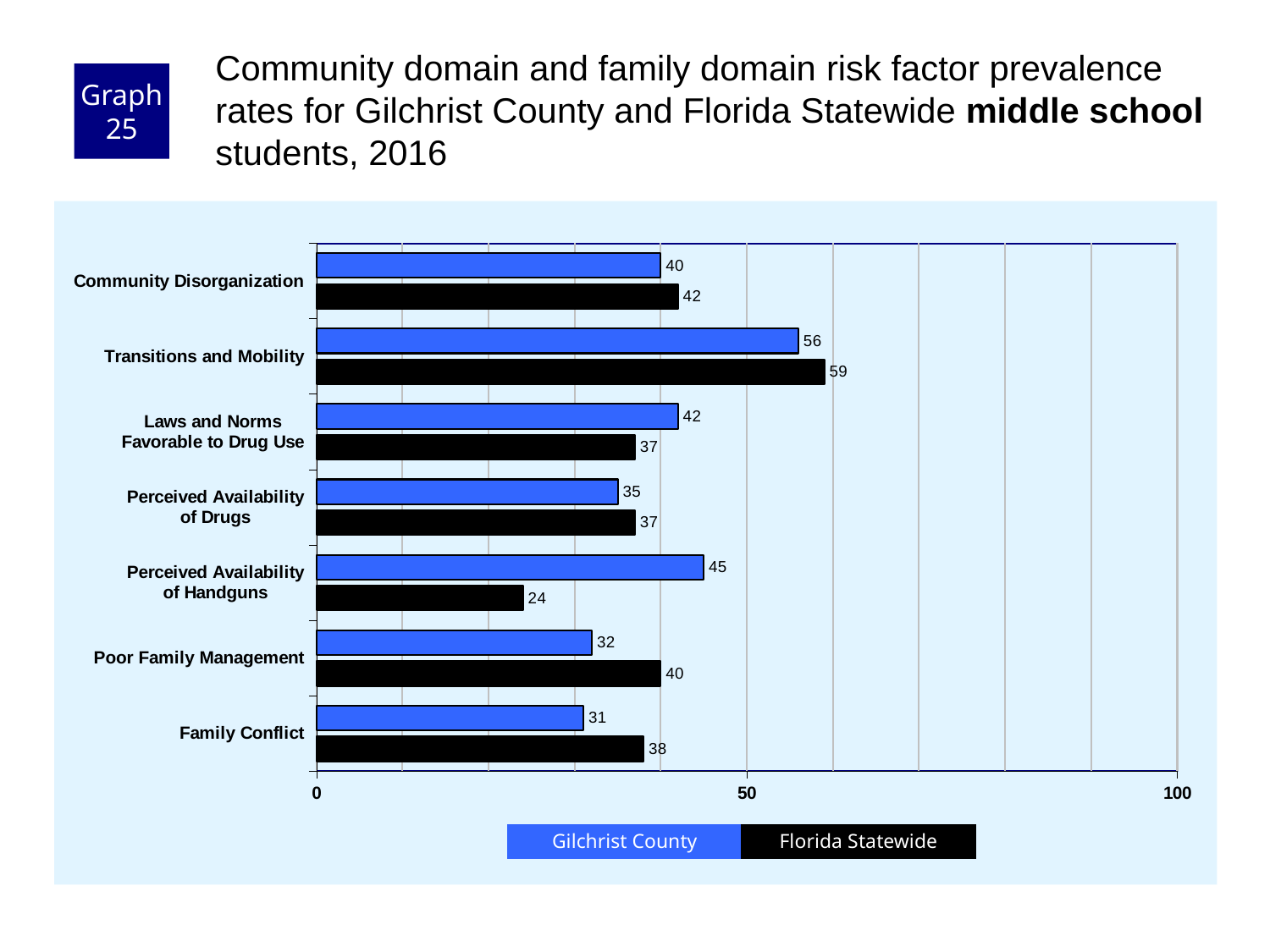
How many series does the legend list? 2 What is the Gilchrist County value for Transitions and Mobility? 56 What is the Gilchrist County value for Family Conflict? 31 Which risk factor has the lowest Gilchrist County value? Family Conflict Is the Florida Statewide value for Transitions and Mobility greater or less than 50? greater What kind of chart is shown on the slide? Bar chart Which risk factor has the highest Florida Statewide value? Transitions and Mobility What is the difference between the Gilchrist County and Florida Statewide values for Perceived Availability of Handguns? 21 What colour are the Florida Statewide bars? Black What is the Florida Statewide value for Perceived Availability of Handguns? 24 How many risk factor categories are shown on the chart? 7 Which is larger for Poor Family Management: the Gilchrist County value or the Florida Statewide value? Florida Statewide